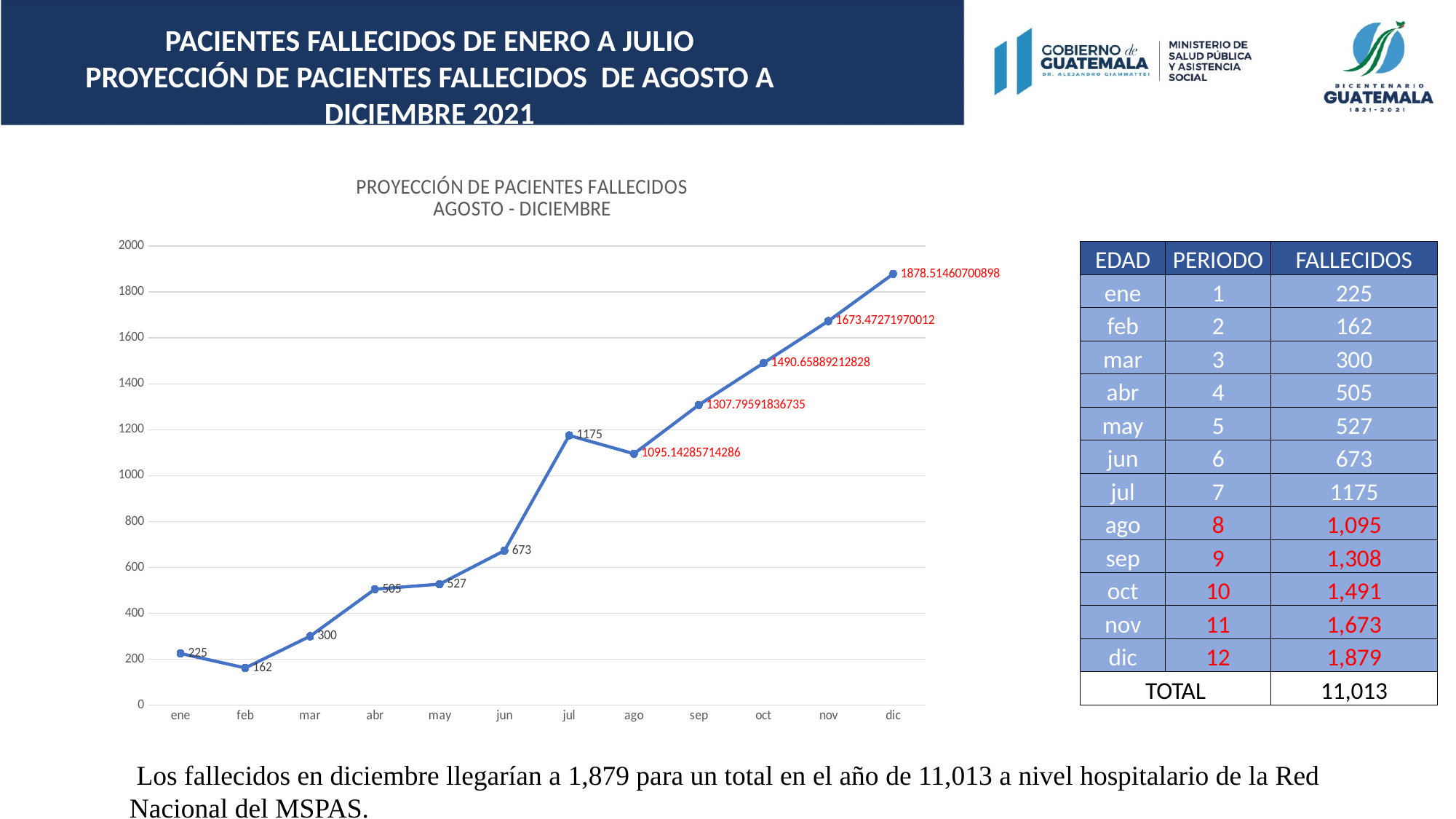
What data label is shown for ago in the line chart? 1095.14285714286 Which month has the highest value in the line chart? dic What is the value plotted for jul in the line chart? 1175 Is the value for oct in the line chart greater or less than 1400? greater How many months are plotted on the x axis of the line chart? 12 What data label is shown for dic in the line chart? 1878.51460700898 What is the difference between the values for jul and jun in the line chart? 502 What kind of chart is shown on the slide? line chart What is the title of the chart on the slide? PROYECCIÓN DE PACIENTES FALLECIDOS AGOSTO - DICIEMBRE Which month has the lowest value in the line chart? feb Which is larger in the line chart, the value for jul or the value for ago? jul What is the value plotted for abr in the line chart? 505